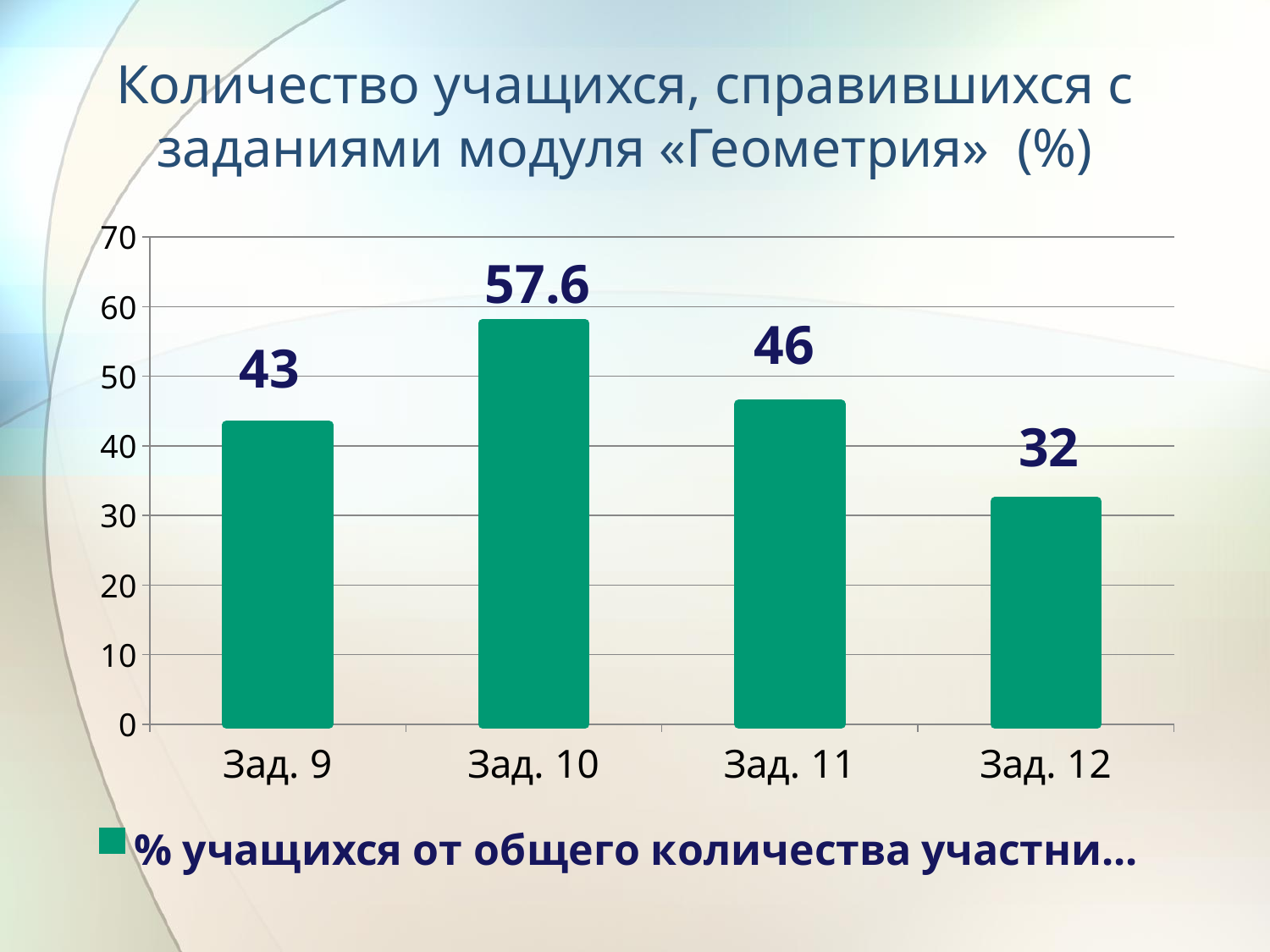
Which category has the highest value? Зад. 10 How many categories are shown on the x axis? 4 What kind of chart is shown on the slide? bar chart Which is larger, the value for Зад. 9 or the value for Зад. 11? Зад. 11 What is the title of the chart? Количество учащихся, справившихся с заданиями модуля «Геометрия» (%) What is the value for Зад. 12? 32 What is the value for Зад. 10? 57.6 Which category has the lowest value? Зад. 12 Is the value for Зад. 11 greater or less than 40? greater What is the value for Зад. 9? 43 What is the difference between the values for Зад. 9 and Зад. 12? 11 What is the difference between the values for Зад. 10 and Зад. 11? 11.6